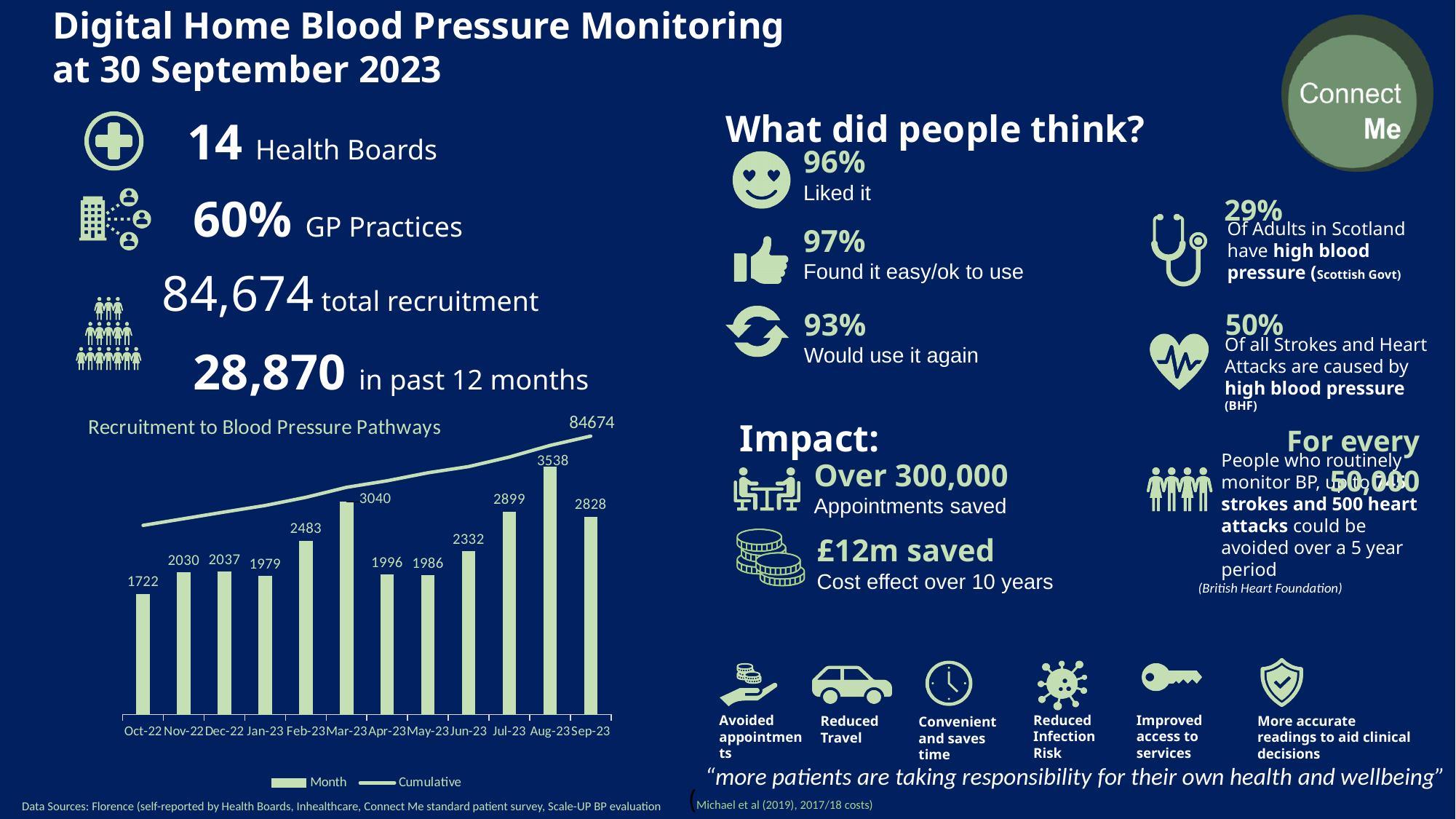
What is the Month value for Mar-23 in the Recruitment to Blood Pressure Pathways chart? 3040 What kind of chart is used for the monthly values in the Recruitment to Blood Pressure Pathways chart? Bar chart What is the difference between the Month values for Aug-23 and Sep-23 in the Recruitment to Blood Pressure Pathways chart? 710 How many series does the legend of the Recruitment to Blood Pressure Pathways chart list? 2 Which month has the lowest Month value in the Recruitment to Blood Pressure Pathways chart? Oct-22 Which month has the highest Month value in the Recruitment to Blood Pressure Pathways chart? Aug-23 Does the Cumulative line in the Recruitment to Blood Pressure Pathways chart rise or fall from Oct-22 to Sep-23? Rise What is the Month value for Oct-22 in the Recruitment to Blood Pressure Pathways chart? 1722 What is the title of the chart on the slide? Recruitment to Blood Pressure Pathways How many months are shown on the x axis of the Recruitment to Blood Pressure Pathways chart? 12 What is the Month value for Sep-23 in the Recruitment to Blood Pressure Pathways chart? 2828 In the Recruitment to Blood Pressure Pathways chart, which is larger, the Month value for Feb-23 or for Jun-23? Feb-23